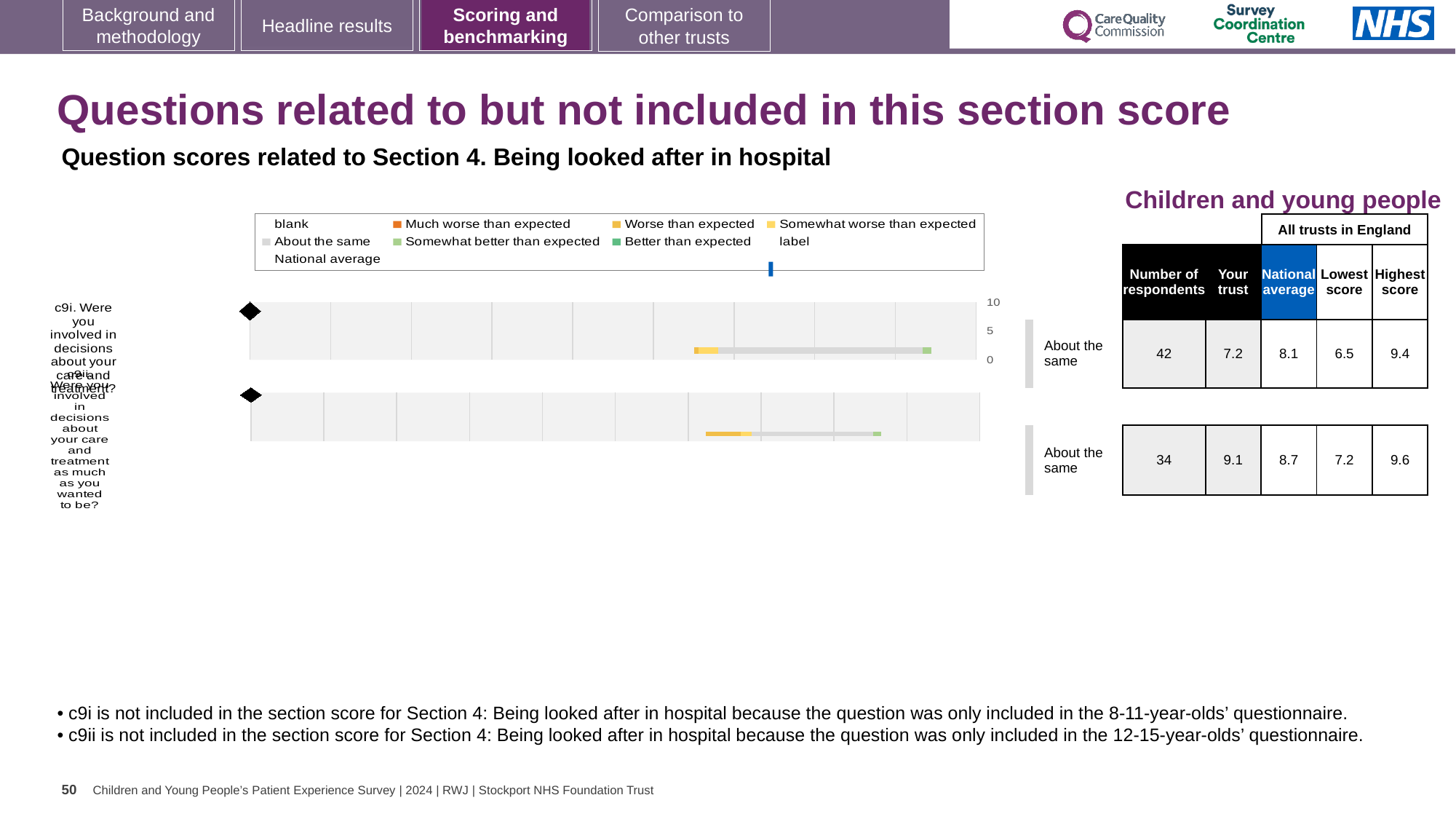
How many respondents answered question c9i? 42 What is the 'Your trust' score for question c9ii? 9.1 What is the difference between the 'Your trust' scores for c9ii and c9i? 1.9 What is the lowest score among all trusts in England for question c9i? 6.5 What benchmark rating is shown for question c9i? About the same How many questions (categories) are plotted in the chart? 2 What is the highest score among all trusts in England for question c9ii? 9.6 What kind of chart is shown on the slide? bar chart What is the national average score for question c9i? 8.1 Which question has the higher 'Your trust' score, c9i or c9ii? c9ii What is the difference in the number of respondents between c9i and c9ii? 8 What is the 'Your trust' score for question c9i? 7.2